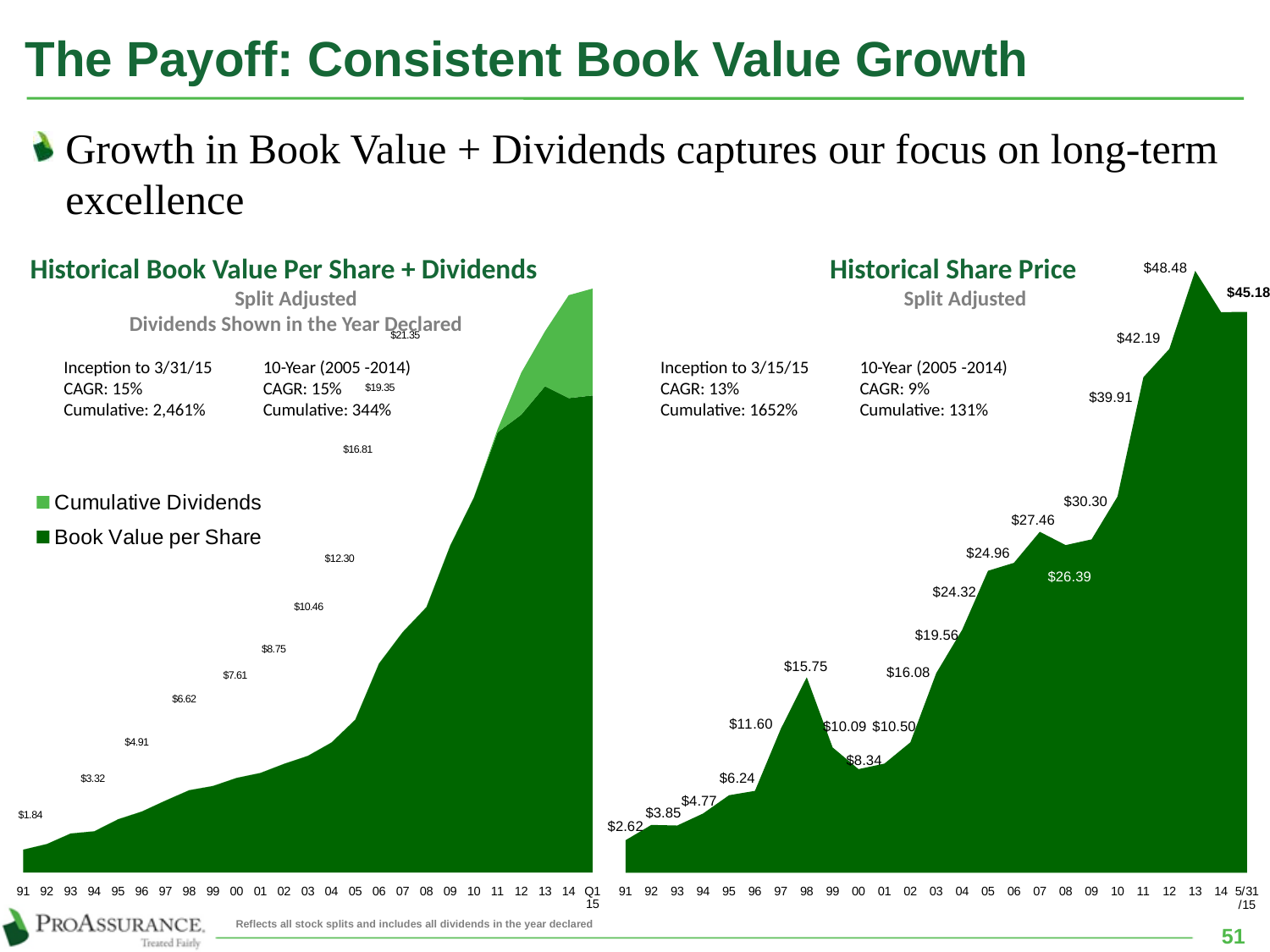
In the Historical Share Price chart, do share prices generally rise or fall from 91 to 5/31/15? rise In the Historical Book Value Per Share + Dividends chart, what is the largest value printed as a data label? $21.35 In the Historical Book Value Per Share + Dividends chart, what is the first book value per share labelled (at 91)? $1.84 In the Historical Share Price chart, what is the difference between the peak value of $48.48 and the final value of $45.18? $3.30 How many points are shown along the x axis of the Historical Share Price chart? 25 In the Historical Share Price chart, what is the highest share price value labelled? $48.48 What kind of chart is the Historical Share Price chart? area chart In the Historical Share Price chart, what is the lowest share price value labelled? $2.62 In the Historical Share Price chart, which is larger: the value labelled $15.75 or the value labelled $8.34? $15.75 In the Historical Share Price chart, what is the share price labelled at 5/31/15? $45.18 How many series does the legend of the Historical Book Value Per Share + Dividends chart list? 2 In the Historical Book Value Per Share + Dividends chart, which series is shown in the lighter green? Cumulative Dividends